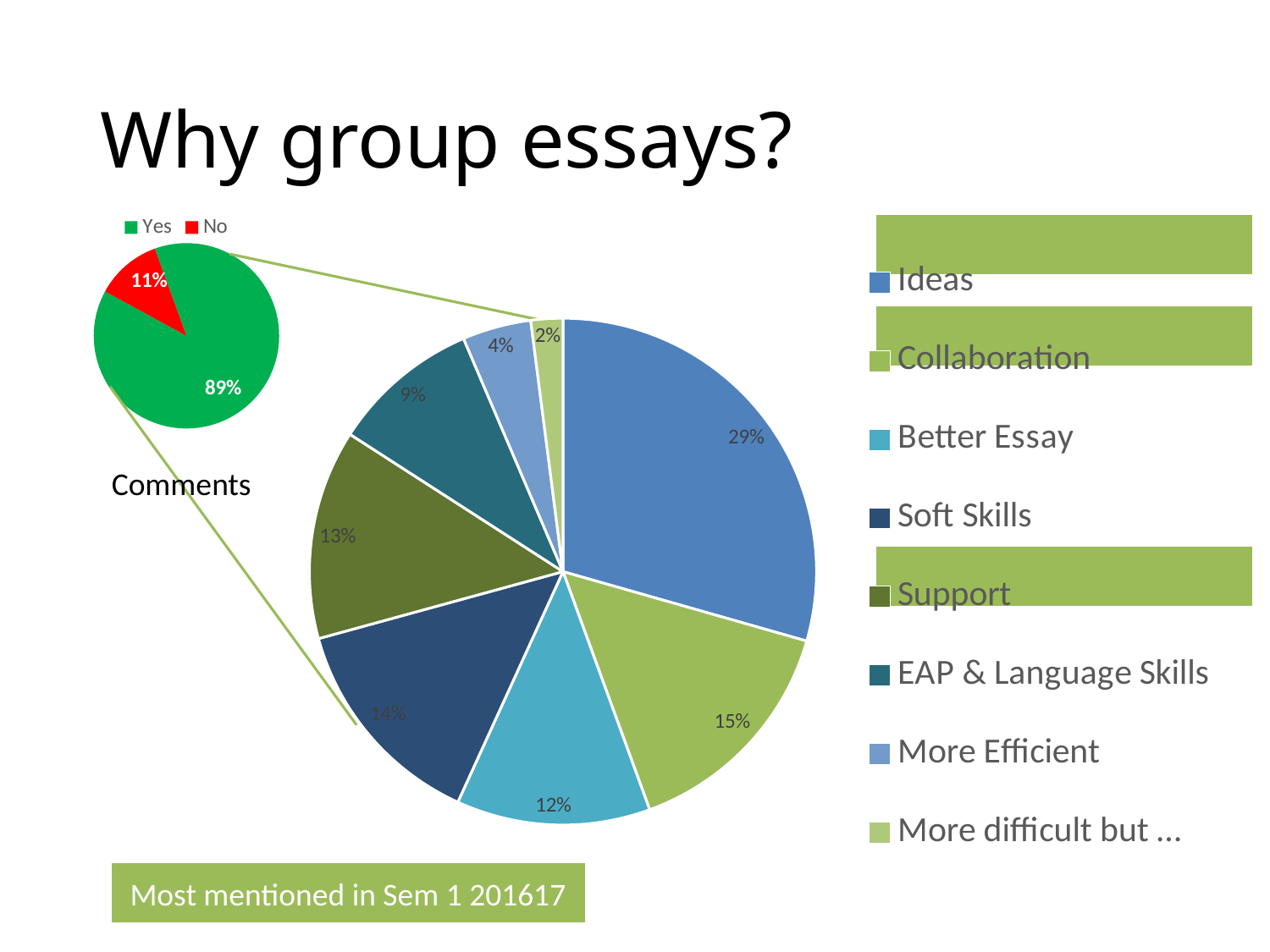
In the large pie chart, what share is shown for Ideas? 29% In the small Yes/No pie chart, what is the difference between the Yes and No shares? 78% In the large pie chart, which is larger, Soft Skills or Better Essay? Soft Skills In the large pie chart, which category has the largest slice? Ideas In the small Yes/No pie chart, what percentage is labelled No? 11% In the large pie chart, what share is shown for Support? 13% In the large pie chart, what share is shown for Collaboration? 15% How many categories does the legend of the large pie chart list? 8 In the large pie chart, what is the difference between the Ideas share and the Collaboration share? 14% In the small Yes/No pie chart, what percentage is labelled Yes? 89% In the large pie chart, which category has the smallest slice? More difficult but … What type of chart is the large chart on the slide? Pie chart